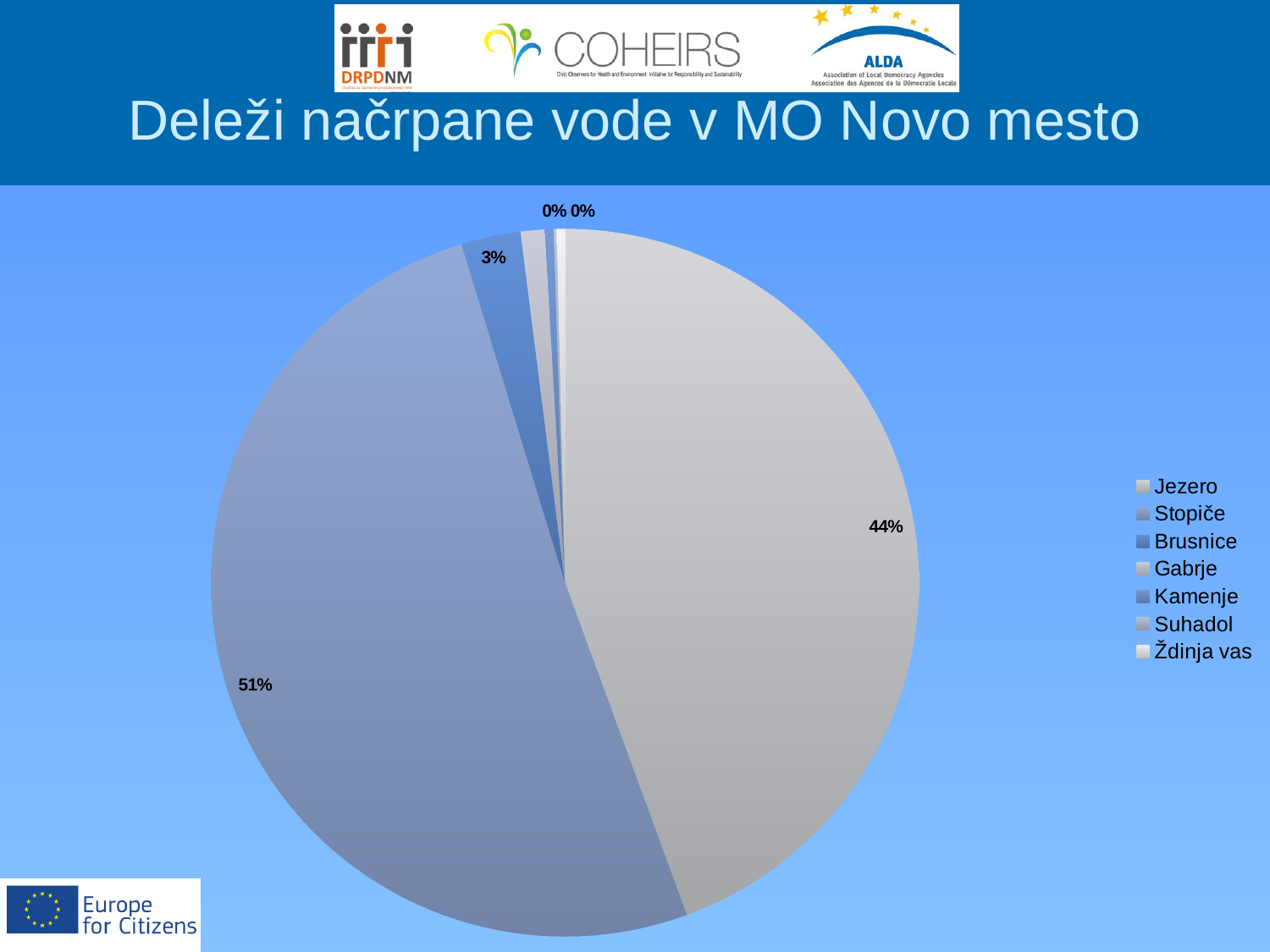
What kind of chart is shown on the slide? pie chart Which is larger, the slice for Stopiče or the slice for Jezero? Stopiče What is the difference in percentage points between the Stopiče slice and the Jezero slice? 7 What is the title of the chart? Deleži načrpane vode v MO Novo mesto How many categories does the legend of the pie chart list? 7 What share of the pie does Jezero have? 44% What share of the pie does Brusnice have? 3% Which is larger, the slice for Jezero or the slice for Brusnice? Jezero Which category has the largest slice of the pie? Stopiče What is the difference in percentage points between the Jezero slice and the Brusnice slice? 41 What share of the pie does Stopiče have? 51% What is the combined share of the Jezero and Stopiče slices? 95%